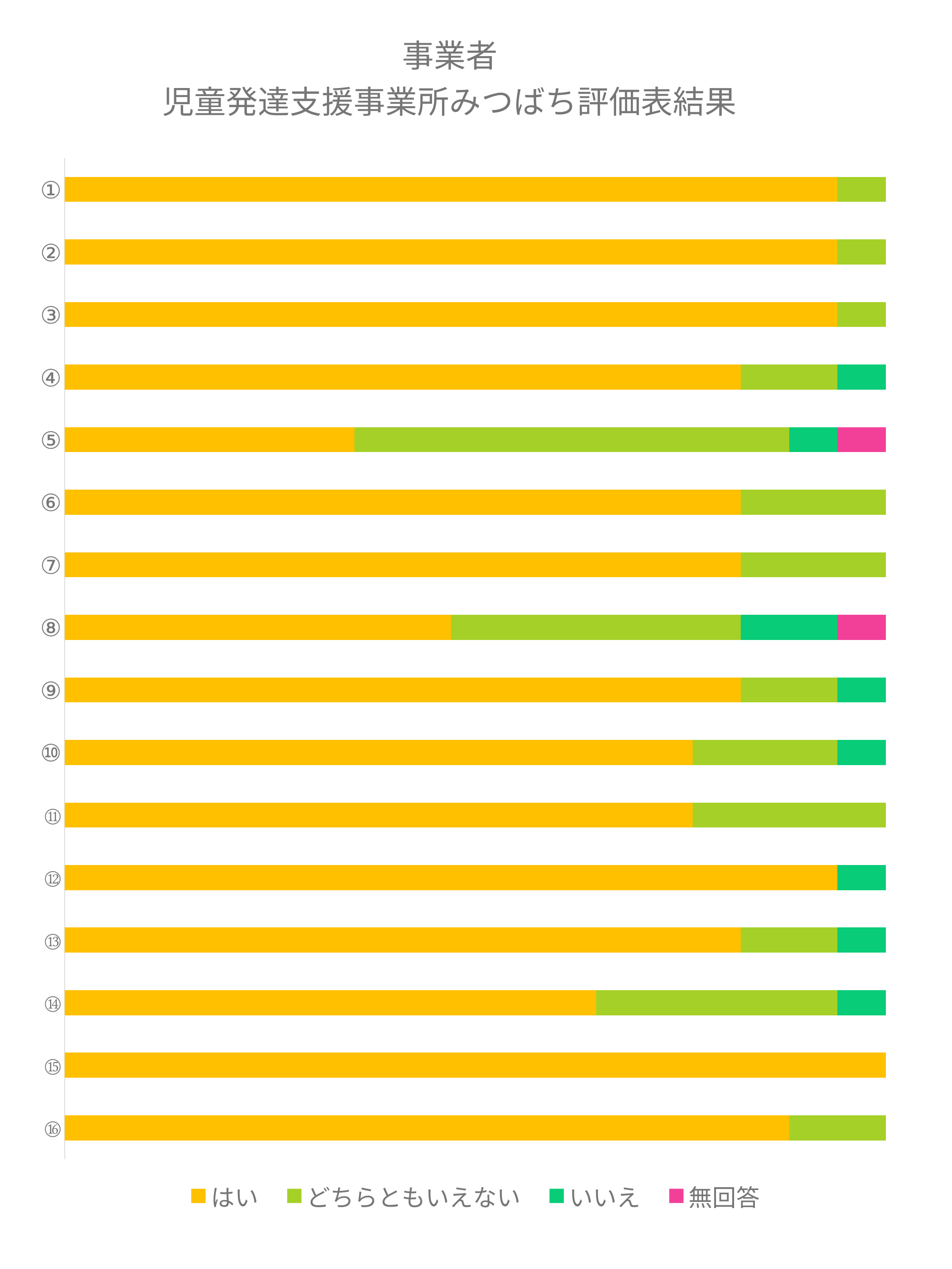
Which category has the smallest はい share? ⑤ What kind of chart is shown on the slide? Stacked bar chart Which category consists entirely of はい responses? ⑮ Which categories include a 無回答 segment? ⑤ and ⑧ Which has the larger はい share, ⑭ or ⑯? ⑯ Which category has the largest はい share? ⑮ Which has the larger はい share, ⑤ or ⑧? ⑧ How many categories (numbered items) are plotted on the chart? 16 Which category has the largest どちらともいえない share? ⑤ How many series does the legend list? 4 Which has the larger はい share, ① or ④? ①